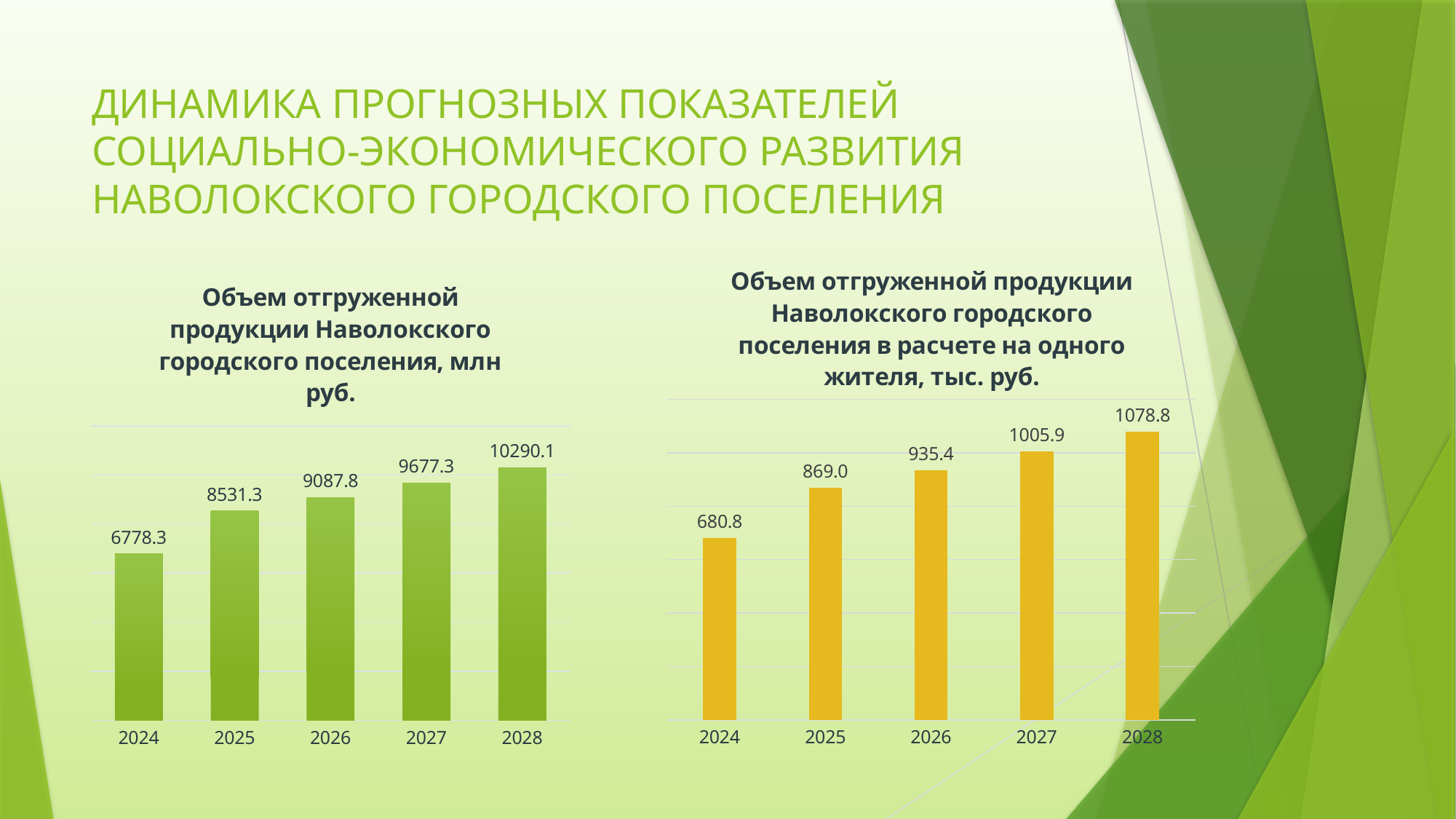
In the left chart (Объем отгруженной продукции, млн руб.), what is the value for 2024? 6778.3 In the right chart (в расчете на одного жителя, тыс. руб.), what is the value for 2028? 1078.8 In the right chart (в расчете на одного жителя, тыс. руб.), which is larger, the value for 2025 or the value for 2027? 2027 In the right chart (в расчете на одного жителя, тыс. руб.), what is the value for 2026? 935.4 In the right chart (в расчете на одного жителя, тыс. руб.), what is the difference between the 2028 and 2024 values? 398.0 In the left chart (Объем отгруженной продукции, млн руб.), what is the value for 2027? 9677.3 What type of chart is the right chart (в расчете на одного жителя, тыс. руб.)? Bar chart In the left chart (Объем отгруженной продукции, млн руб.), do the values rise or fall from 2024 to 2028? Rise How many years are shown on the x axis of the left chart (Объем отгруженной продукции, млн руб.)? 5 In the left chart (Объем отгруженной продукции, млн руб.), what is the difference between the 2028 and 2024 values? 3511.8 In the right chart (в расчете на одного жителя, тыс. руб.), which year has the lowest value? 2024 In the left chart (Объем отгруженной продукции, млн руб.), which year has the highest value? 2028